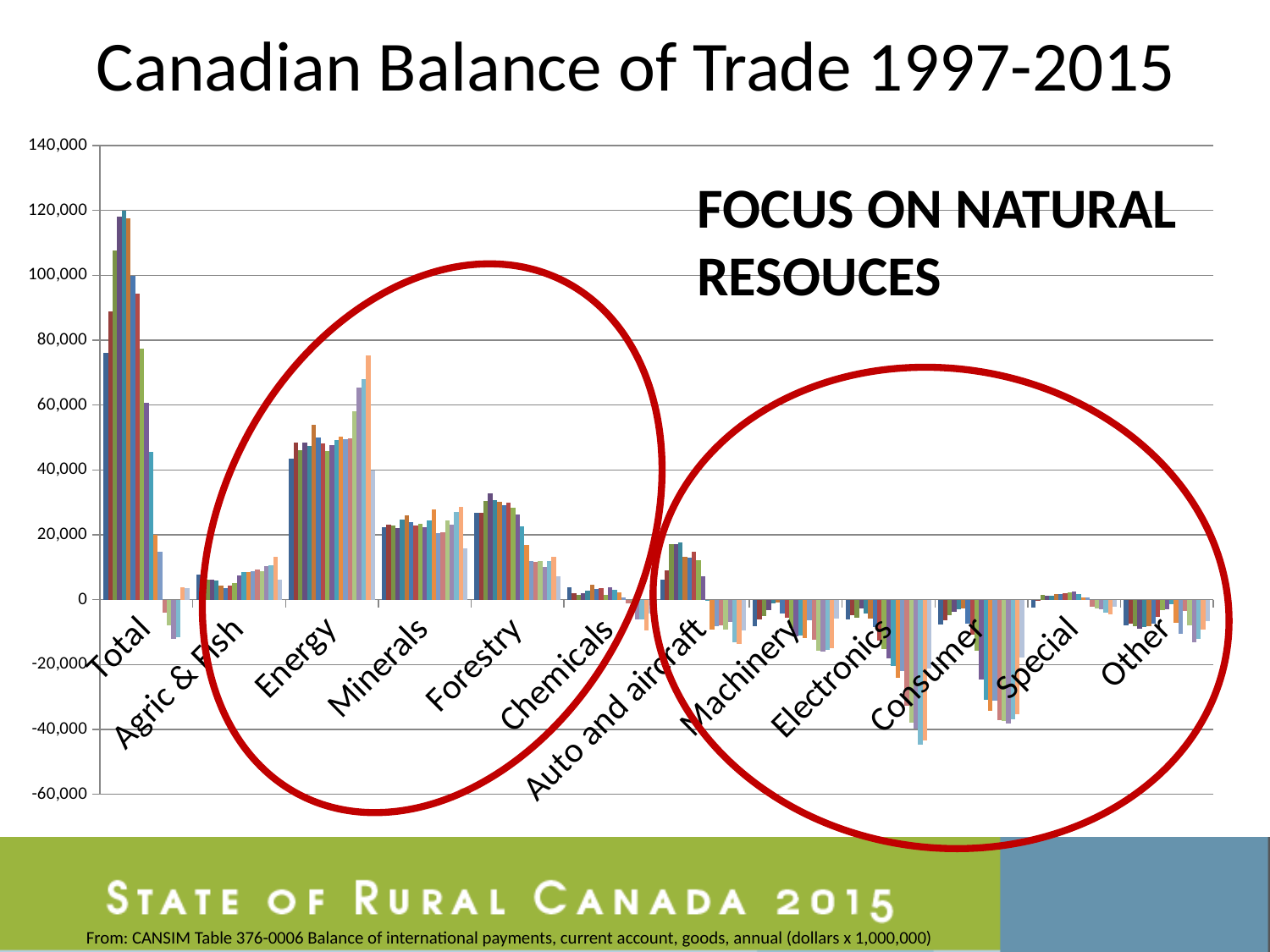
How many categories are shown along the x axis of the chart? 12 What is the title of the chart on the slide? Canadian Balance of Trade 1997-2015 Is the lowest bar for Special greater or less than -20,000? greater Is the tallest bar for Total greater or less than 100,000? greater Is the tallest bar for Forestry greater or less than 40,000? less What kind of chart is shown on the slide? bar chart Which category has the lowest (most negative) bars in the chart? Electronics What text is written inside the chart area next to the red circles? FOCUS ON NATURAL RESOUCES Which category has larger values overall, Energy or Minerals? Energy Which category has the highest bars in the chart? Total